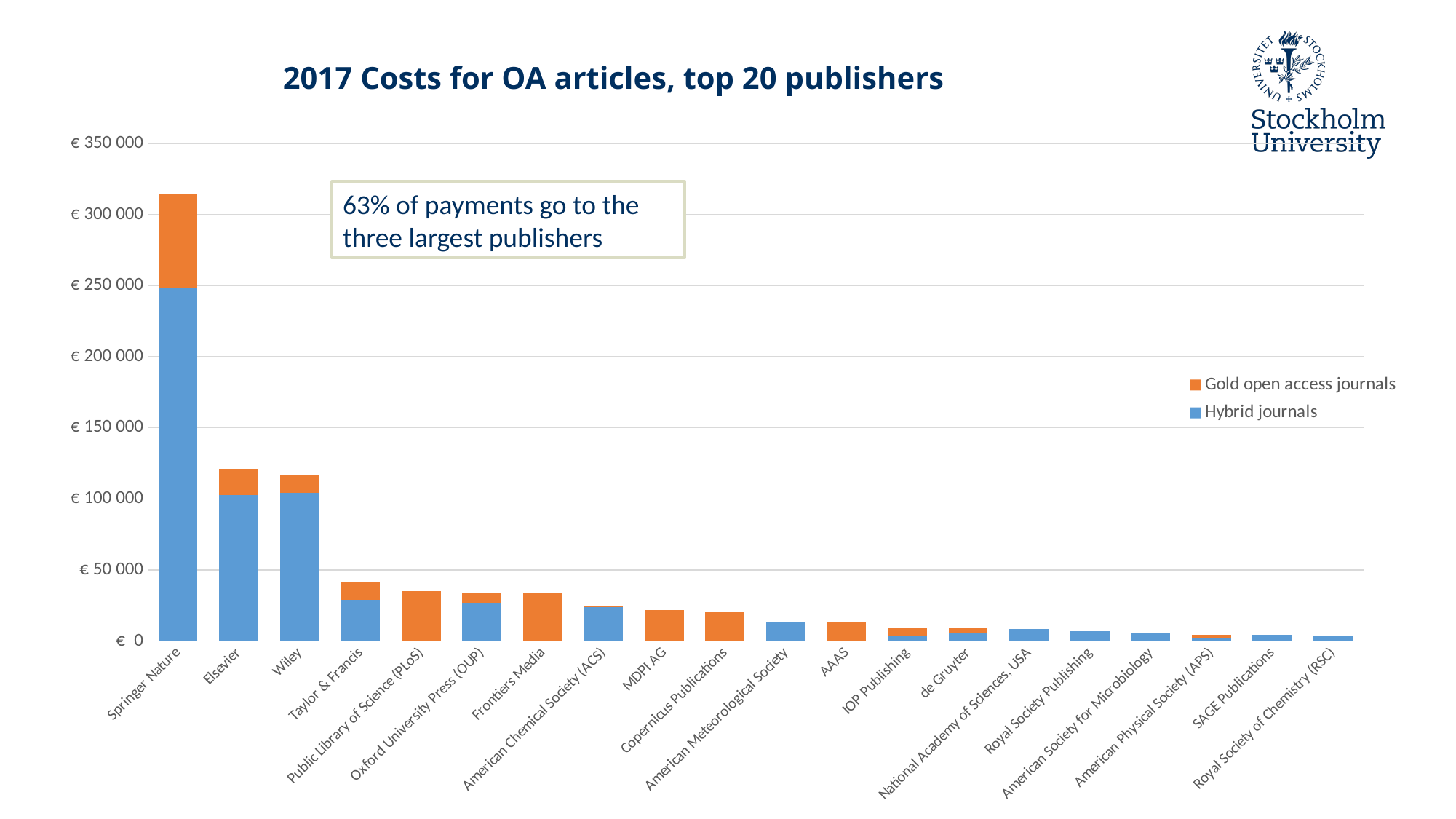
What kind of chart is shown on the slide? Stacked bar chart How many publishers are shown on the x axis of the chart? 20 Is the Hybrid journals value for Springer Nature greater or less than € 200 000? greater Which series is shown in orange in the chart? Gold open access journals Is the total value for Elsevier greater or less than € 100 000? greater Which has a larger total cost, Taylor & Francis or MDPI AG? Taylor & Francis Is the total value for Taylor & Francis greater or less than € 50 000? less Do the total values rise or fall moving from left to right along the x axis? Fall Which publisher has the highest total cost for OA articles? Springer Nature How many series does the legend list? 2 Which has a larger total cost, Springer Nature or Elsevier? Springer Nature